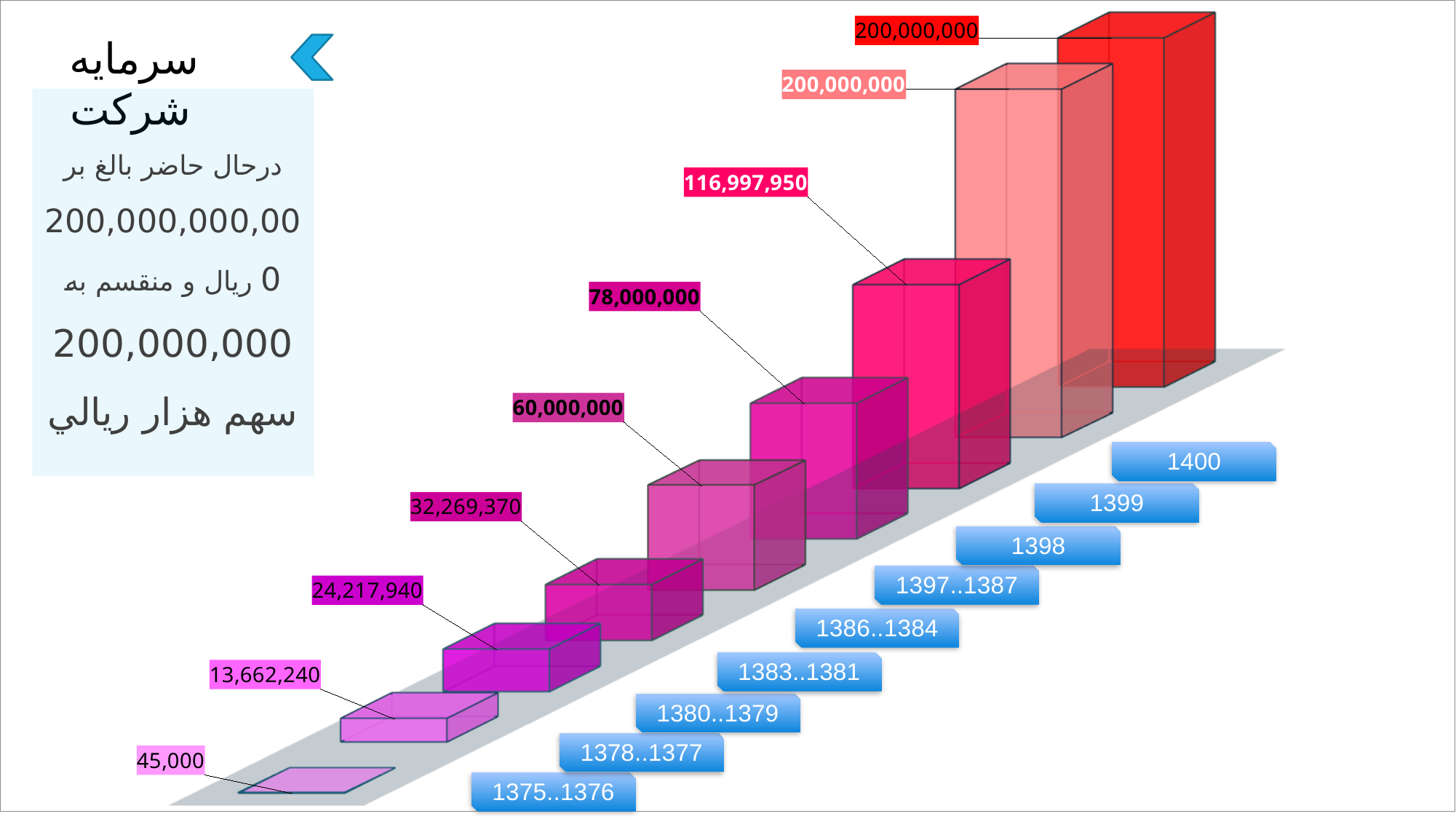
What is the value for 1400? 200,000,000 What kind of chart is shown on the slide? bar chart Do the values rise or fall from 1375..1376 to 1400? rise Which period has the lowest value? 1375..1376 What is the value for 1398? 116,997,950 What is the difference between the values for 1380..1379 and 1378..1377? 10,555,700 How many periods (bars) are shown in the chart? 9 Which is larger, the value for 1398 or the value for 1397..1387? 1398 What is the value for the 1378..1377 period? 13,662,240 What is the value for the 1383..1381 period? 32,269,370 What is the value for the 1375..1376 period? 45,000 What is the difference between the values for 1397..1387 and 1386..1384? 18,000,000